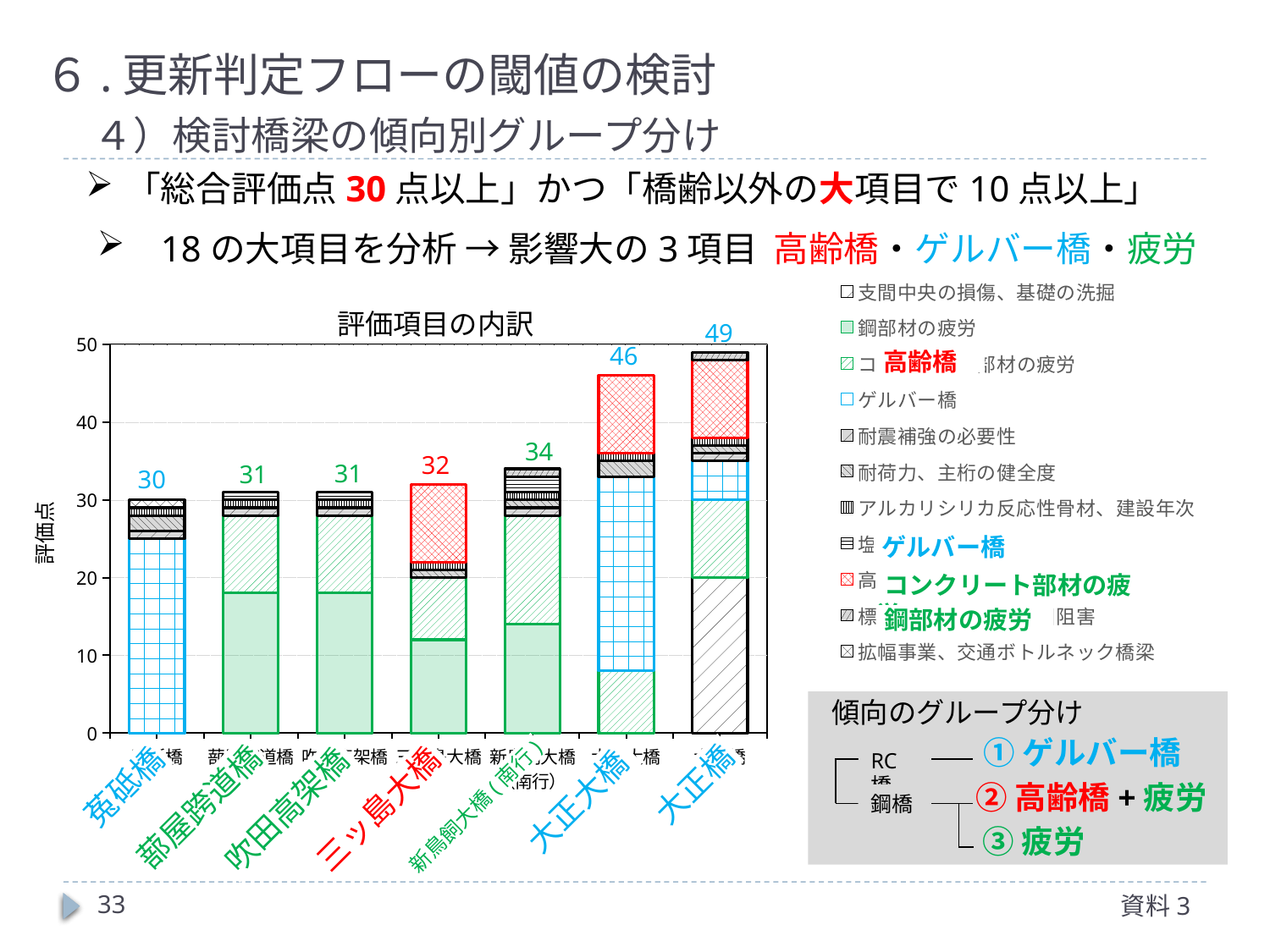
What is the total score shown for 三ッ島大橋? 32 Do the total scores rise or fall from left to right along the x axis? Rise What is the difference between the total scores of 大正橋 and 大正大橋? 3 Which has a higher total score, 大正大橋 or 新鳥飼大橋(南行)? 大正大橋 Which bridge has the lowest total score in the chart? 菟砥橋 What kind of chart is 評価項目の内訳? Stacked bar chart How many bridges are plotted on the x axis of the chart? 7 What is the total score shown for 菟砥橋? 30 What is the total score shown for 大正橋 in the chart 評価項目の内訳? 49 Which bridge has the highest total score in the chart? 大正橋 What is the total score shown for 新鳥飼大橋(南行)? 34 What is the label of the y axis of the chart? 評価点